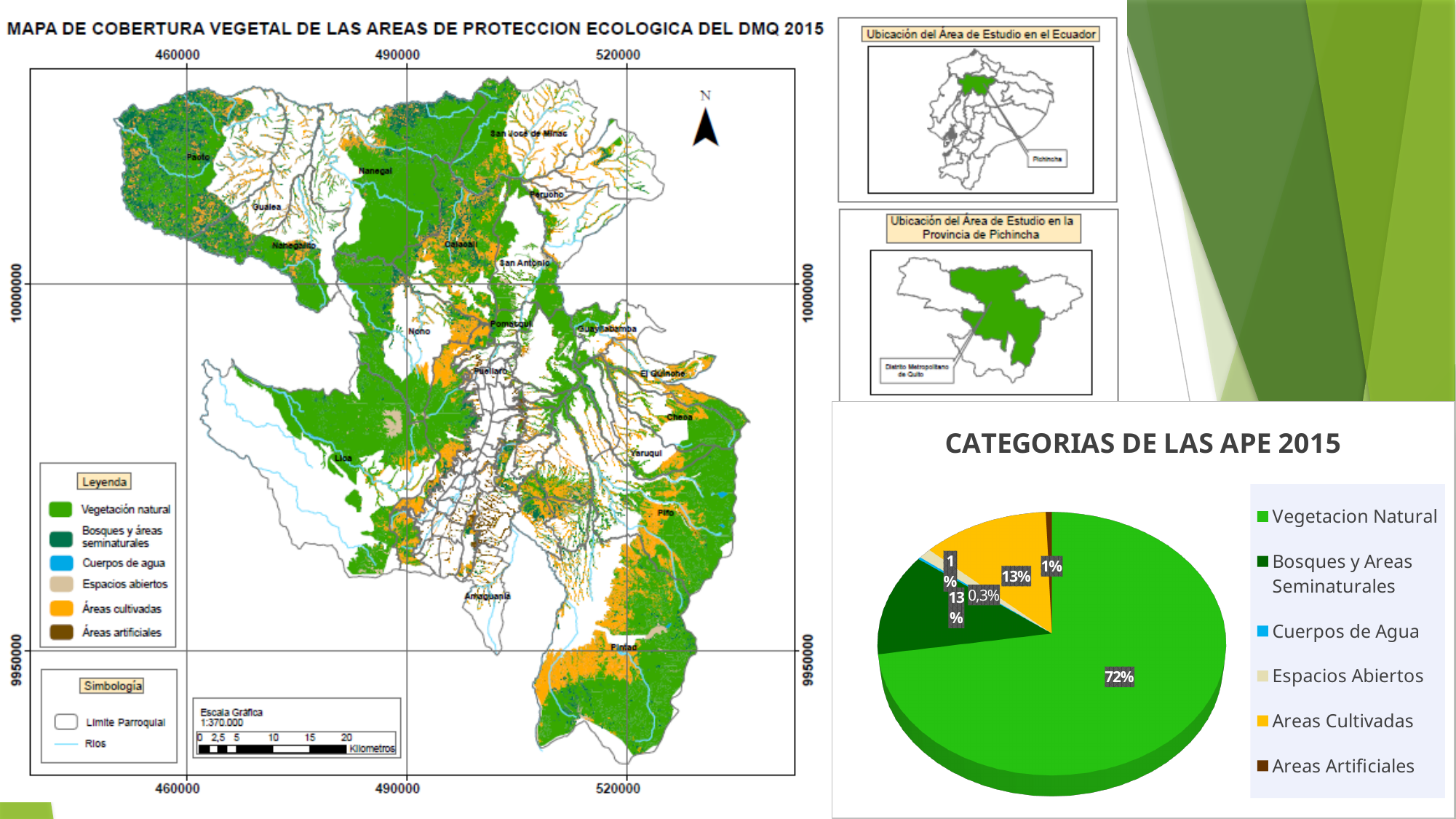
In the pie chart 'CATEGORIAS DE LAS APE 2015', what share does Bosques y Areas Seminaturales have? 13% In the pie chart 'CATEGORIAS DE LAS APE 2015', what share does Vegetacion Natural have? 72% In the pie chart 'CATEGORIAS DE LAS APE 2015', what share does Areas Cultivadas have? 13% In the pie chart 'CATEGORIAS DE LAS APE 2015', how many percentage points larger is Vegetacion Natural than Areas Cultivadas? 59 What is the title of the pie chart on the right side of the slide? CATEGORIAS DE LAS APE 2015 What kind of chart is 'CATEGORIAS DE LAS APE 2015'? pie chart In the pie chart 'CATEGORIAS DE LAS APE 2015', what colour is the Areas Cultivadas slice? yellow In the pie chart 'CATEGORIAS DE LAS APE 2015', which category has the largest share? Vegetacion Natural In the pie chart 'CATEGORIAS DE LAS APE 2015', what is the combined share of Bosques y Areas Seminaturales and Areas Cultivadas? 26% In the pie chart 'CATEGORIAS DE LAS APE 2015', what share does Areas Artificiales have? 1% How many categories does the pie chart 'CATEGORIAS DE LAS APE 2015' show? 6 In the pie chart 'CATEGORIAS DE LAS APE 2015', which is larger: Vegetacion Natural or Bosques y Areas Seminaturales? Vegetacion Natural